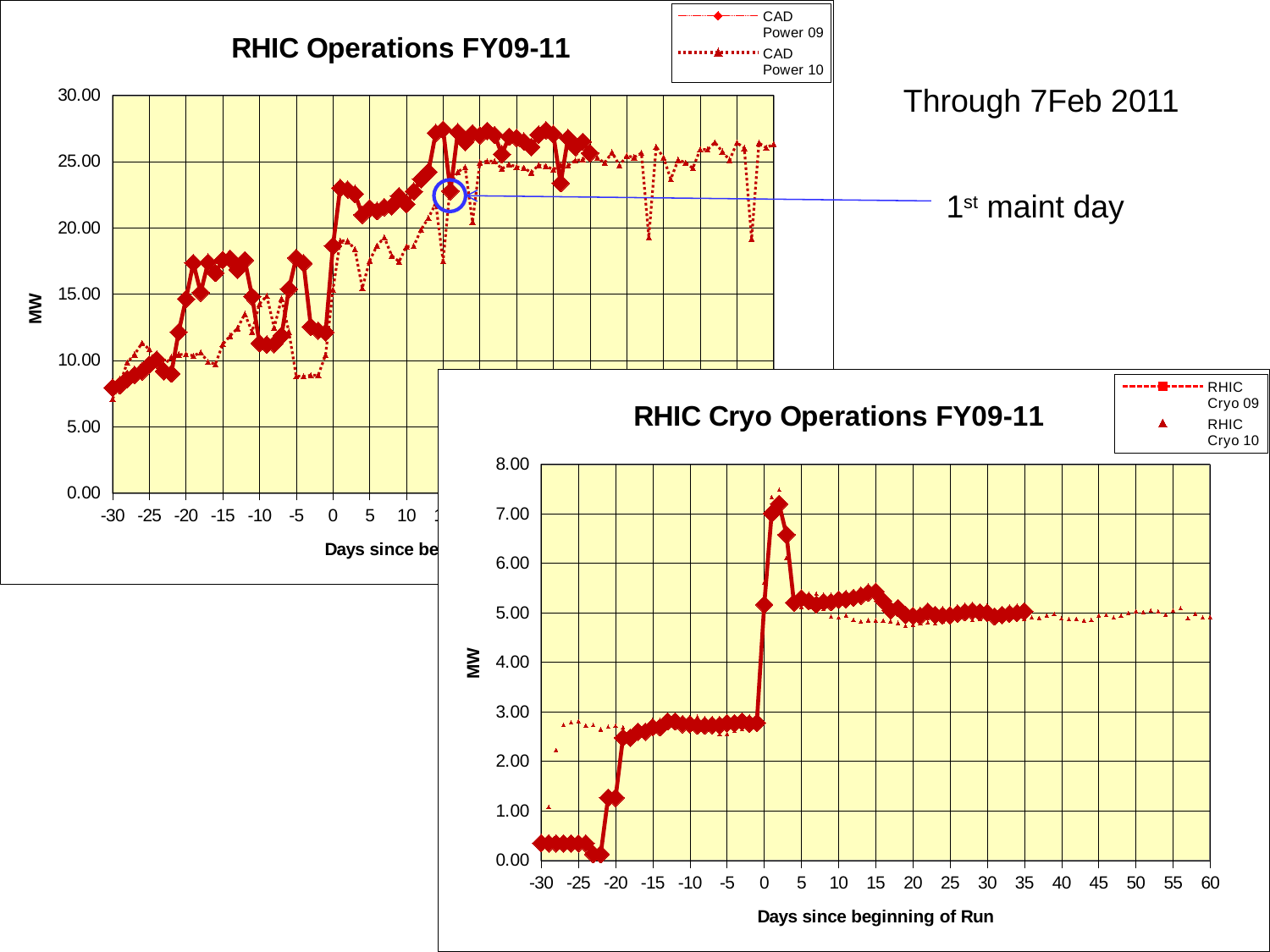
How many series does the legend of the RHIC Cryo Operations FY09-11 chart list? 2 In the RHIC Operations FY09-11 chart, is the CAD Power 09 value at day 30 greater or less than 25.00? greater What kind of chart is the RHIC Operations FY09-11 chart? line chart In the RHIC Cryo Operations FY09-11 chart, is the RHIC Cryo 09 value at day -10 greater or less than 2.00? greater What does the annotation pointing to the circled point on the RHIC Operations FY09-11 chart say? 1st maint day In the RHIC Cryo Operations FY09-11 chart, does the RHIC Cryo 09 series rise or fall overall from day -30 to day 0? rise In the RHIC Operations FY09-11 chart, is the CAD Power 09 value at day 0 greater or less than 20.00? less How many series does the legend of the RHIC Operations FY09-11 chart list? 2 What is the x-axis title of the RHIC Cryo Operations FY09-11 chart? Days since beginning of Run